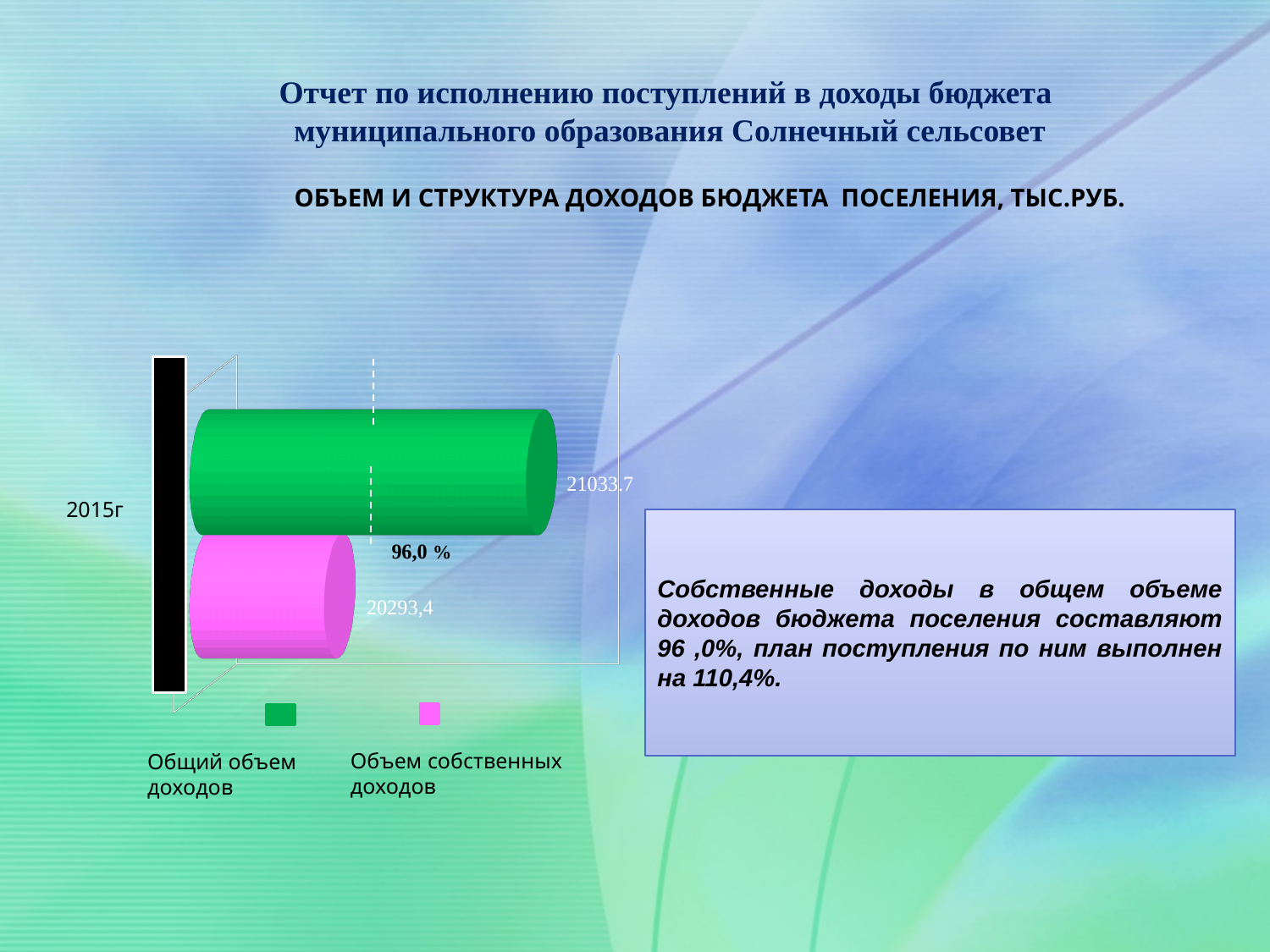
What is the value for Общий объем доходов in 2015г? 21033.7 What kind of chart is shown on the slide? bar chart Which is larger, Общий объем доходов or Объем собственных доходов? Общий объем доходов What is the category label shown on the chart's axis? 2015г Which series has the highest value on the chart? Общий объем доходов How many categories are shown on the chart's category axis? 1 What percentage label is printed between the two bars on the chart? 96,0 % How many series does the legend list? 2 What is the value for Объем собственных доходов in 2015г? 20293,4 What is the difference between Общий объем доходов and Объем собственных доходов? 740,3 Which series has the lowest value on the chart? Объем собственных доходов What colour is the bar for Общий объем доходов? green